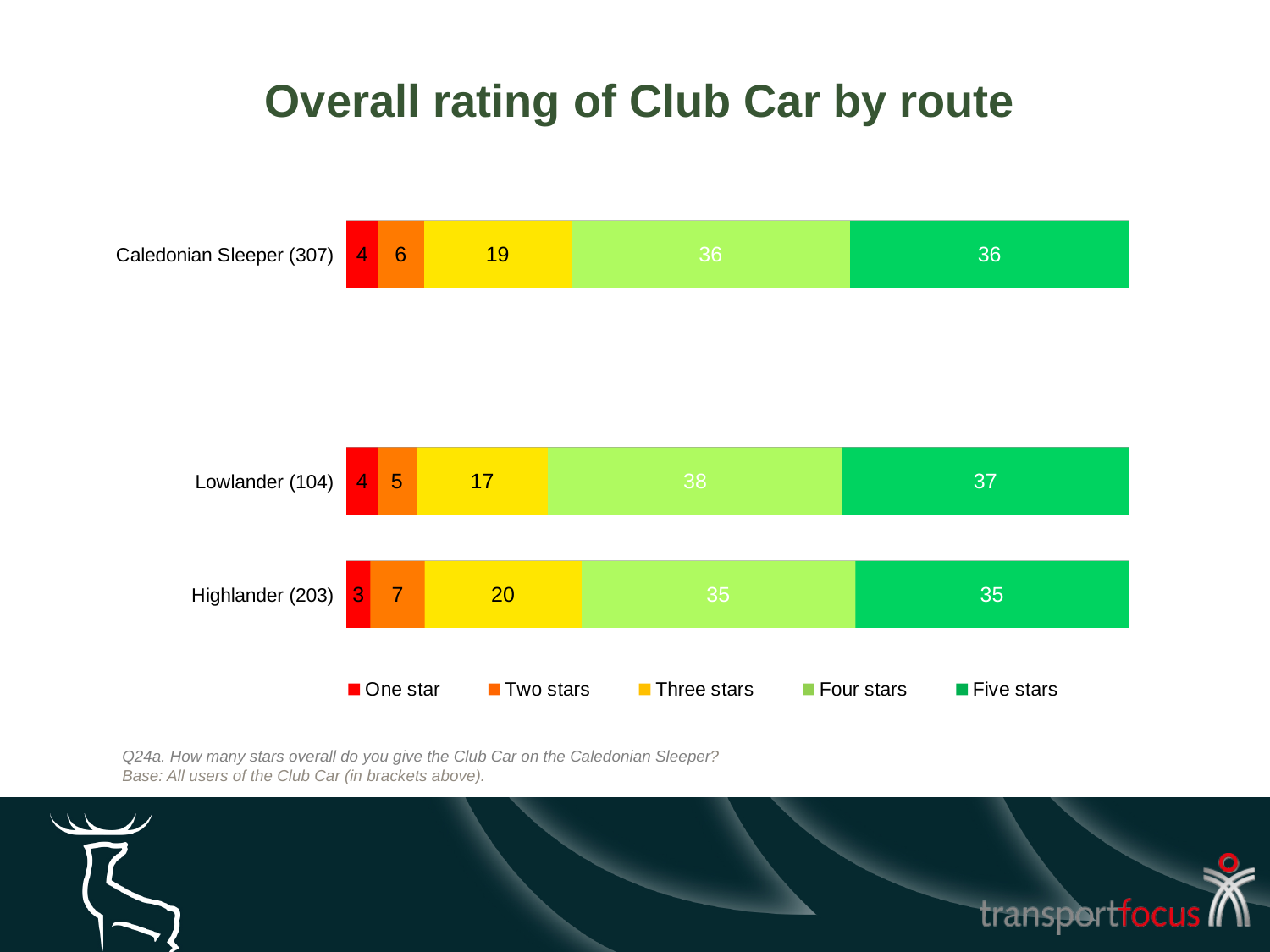
What is the Three stars value for Highlander (203)? 20 What kind of chart is shown on the slide? Stacked bar chart Which route has the lowest Two stars value? Lowlander (104) What is the total of the stacked bar for Lowlander (104)? 101 What is the Four stars value for Lowlander (104)? 38 Which is larger: the Five stars value for Lowlander (104) or for Highlander (203)? Lowlander (104) What is the Five stars value for Caledonian Sleeper (307)? 36 What is the difference between the Three stars values for Highlander (203) and Lowlander (104)? 3 Which route has the highest Four stars value? Lowlander (104) What is the One star value for Highlander (203)? 3 How many routes are shown in the chart? 3 How many series does the legend list? 5